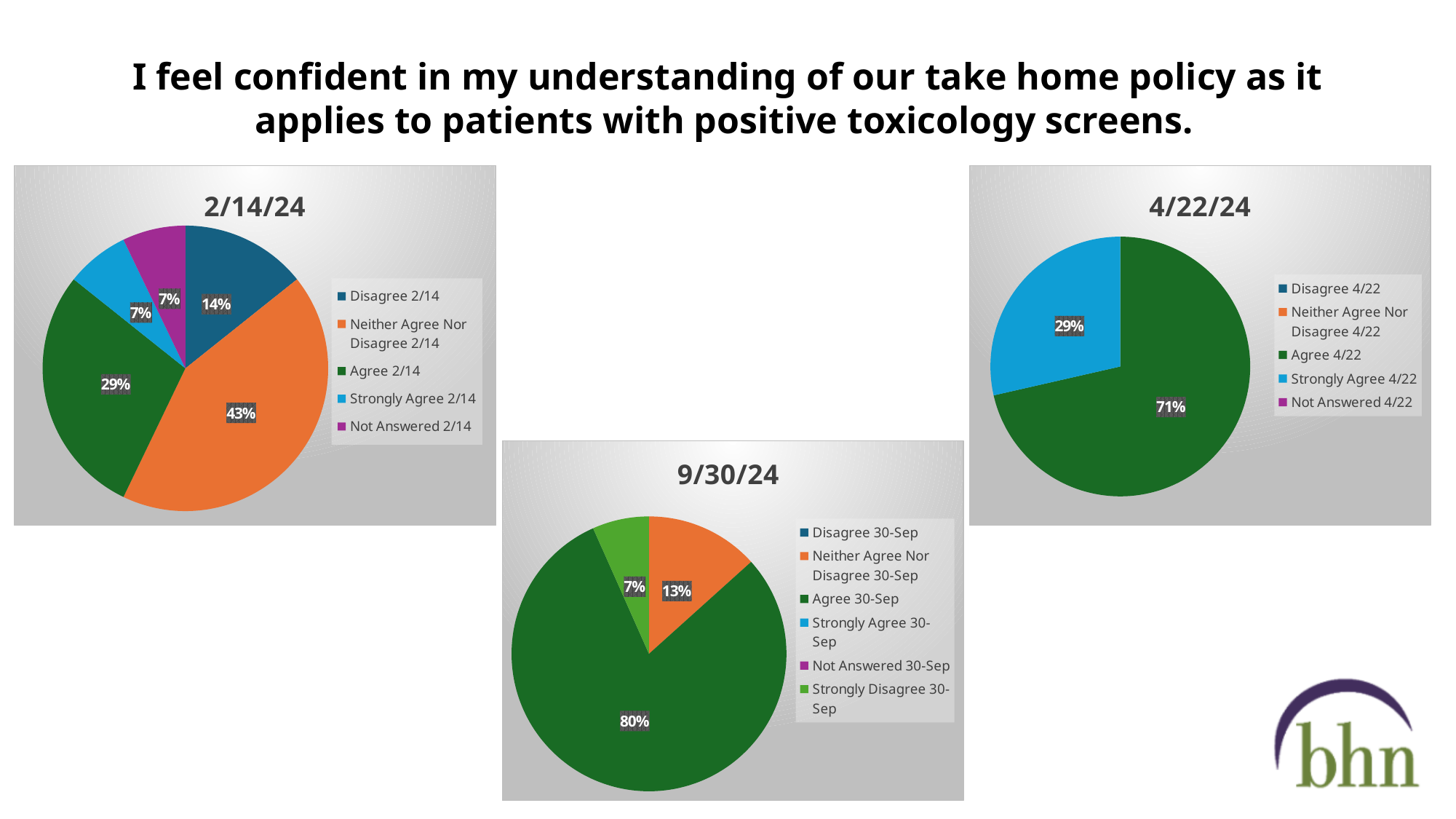
In the 2/14/24 chart, which response has the largest share? Neither Agree Nor Disagree In the 9/30/24 chart, what percentage is shown for Agree? 80% In the 9/30/24 chart, what percentage is shown for Strongly Disagree? 7% In the 9/30/24 chart, what is the difference between the Agree share and the Neither Agree Nor Disagree share? 67% In the 2/14/24 chart, what is the difference between the Neither Agree Nor Disagree share and the Agree share? 14% In the 2/14/24 chart, what percentage is shown for Disagree? 14% How many entries does the legend of the 9/30/24 chart list? 6 In the 2/14/24 chart, what percentage is shown for Neither Agree Nor Disagree? 43% In the 4/22/24 chart, what percentage is shown for Strongly Agree? 29% What type of chart is the 4/22/24 chart? Pie chart In the 4/22/24 chart, which is larger, Agree or Strongly Agree? Agree In the 4/22/24 chart, what percentage is shown for Agree? 71%